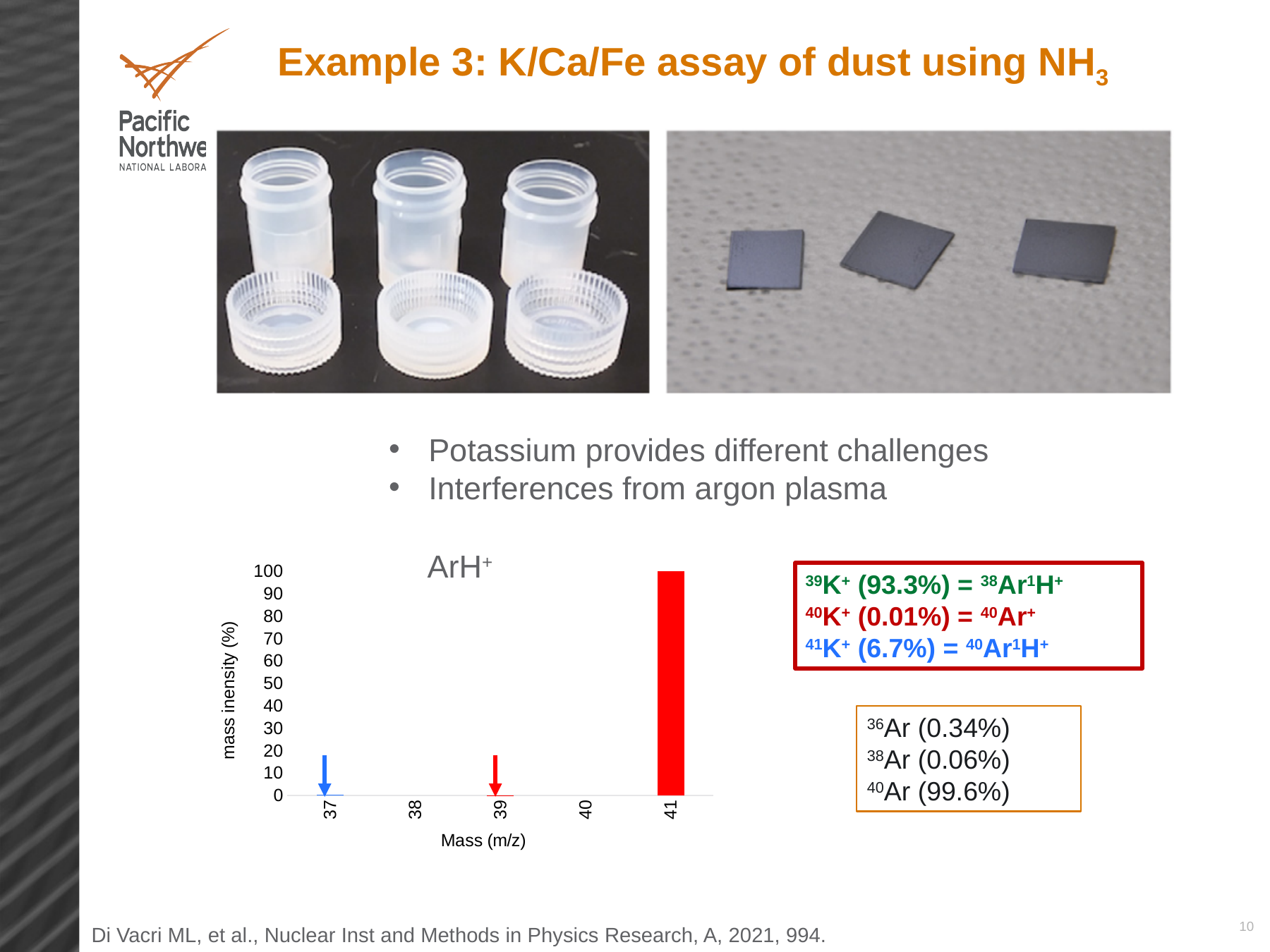
What is the title of the chart at the bottom left of the slide? ArH+ In the ArH+ chart, is the mass intensity at m/z 37 greater or less than 10? less In the ArH+ chart, what is the mass intensity (%) at m/z 41? 100 How many mass (m/z) values are labelled on the x axis of the ArH+ chart? 5 Which mass (m/z) has the highest mass intensity in the ArH+ chart? 41 In the ArH+ chart, which has the larger mass intensity, m/z 39 or m/z 41? 41 In the ArH+ chart, is the mass intensity at m/z 41 greater or less than 90? greater What kind of chart is shown at the bottom left of the slide? bar chart What is the highest value shown on the y axis of the ArH+ chart? 100 In the ArH+ chart, is the mass intensity at m/z 39 greater or less than 10? less What is the x-axis label of the ArH+ chart? Mass (m/z)